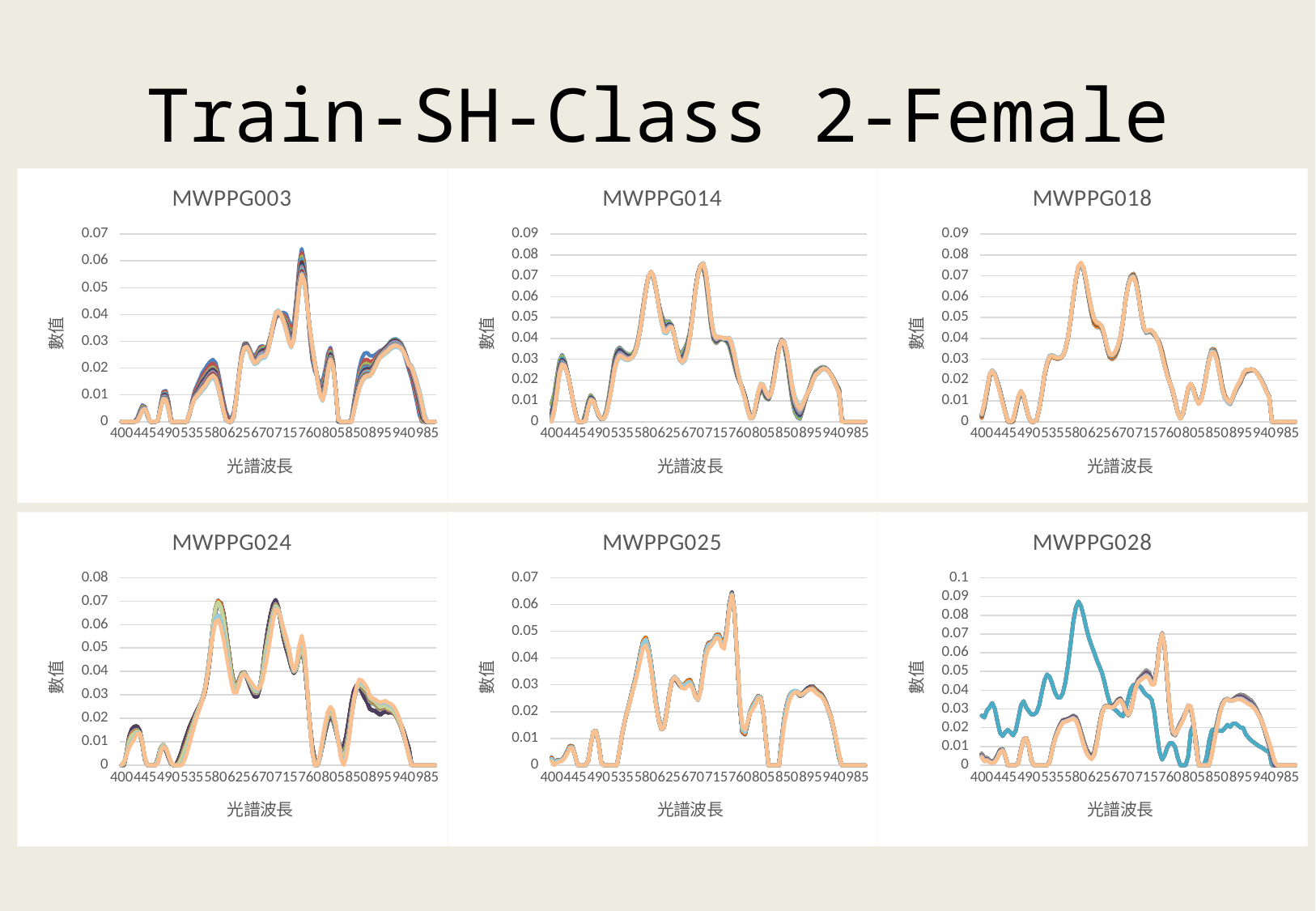
What kind of chart is MWPPG003? line chart In the MWPPG025 chart, is the highest peak near 760 greater or less than 0.06? greater How many charts are shown on the slide? 6 In the MWPPG018 chart, do the values rise or fall between 940 and 985 on the x axis? fall In the MWPPG018 chart, is the peak near 580 greater or less than 0.07? greater In the MWPPG028 chart, at 580 on the x axis, which is higher: the blue line or the orange line? the blue line In the MWPPG003 chart, is the highest peak near 715 greater or less than 0.06? greater What is the x-axis title of the MWPPG014 chart? 光譜波長 What is the highest y-axis tick shown on the MWPPG028 chart? 0.1